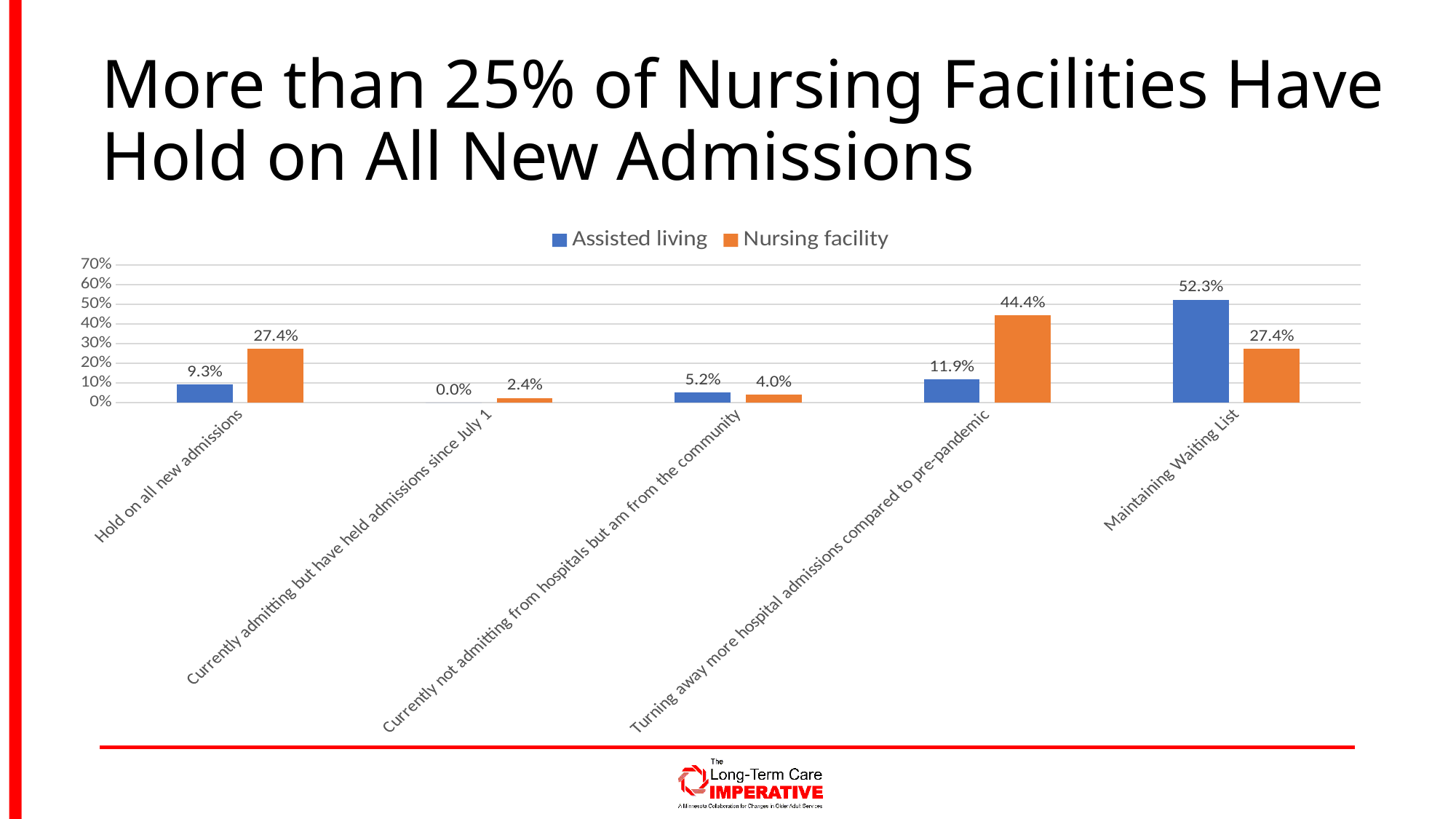
For "Maintaining Waiting List", which series has the larger value, Assisted living or Nursing facility? Assisted living What is the Nursing facility value for "Hold on all new admissions"? 27.4% What is the Assisted living value for "Currently admitting but have held admissions since July 1"? 0.0% How many categories are shown on the x axis? 5 What kind of chart is shown on the slide? Bar chart What is the difference between the Nursing facility and Assisted living values for "Hold on all new admissions"? 18.1% How many series does the legend list? 2 Which category has the highest Nursing facility value? Turning away more hospital admissions compared to pre-pandemic Is the Nursing facility value for "Turning away more hospital admissions compared to pre-pandemic" greater or less than 40%? greater What is the Nursing facility value for "Turning away more hospital admissions compared to pre-pandemic"? 44.4% What is the Assisted living value for "Maintaining Waiting List"? 52.3% Which category has the lowest Nursing facility value? Currently admitting but have held admissions since July 1